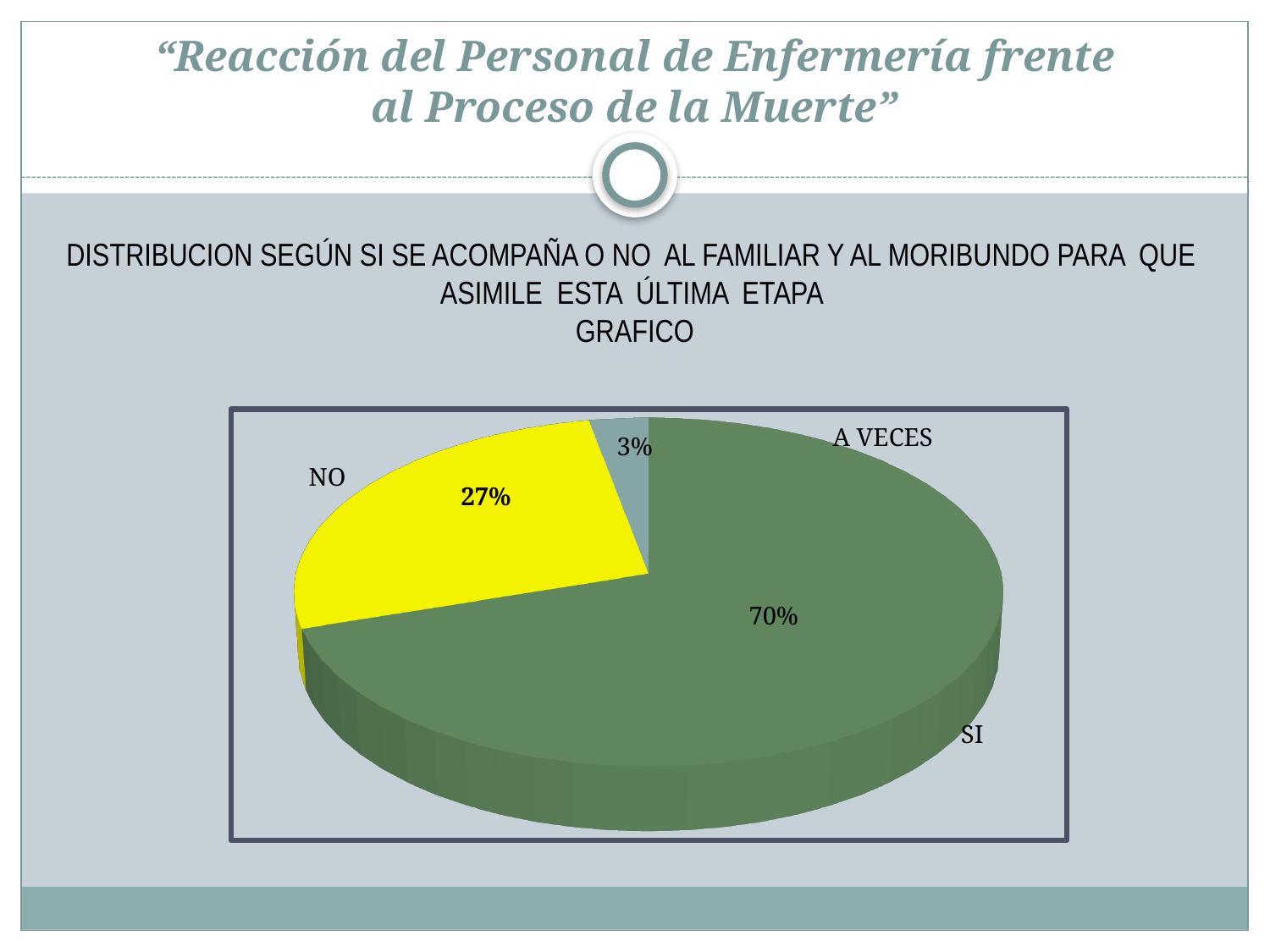
What percentage of the pie corresponds to SI? 70% How many slices does the pie chart have? 3 What is the difference in percentage points between SI and NO? 43 What kind of chart is shown on the slide? Pie chart What is the difference in percentage points between NO and A VECES? 24 What percentage of the pie corresponds to NO? 27% Which is larger, the share for NO or the share for A VECES? NO What colour is the SI slice? Green Which category has the smallest share of the pie? A VECES What colour is the NO slice? Yellow Which category has the largest share of the pie? SI What percentage of the pie corresponds to A VECES? 3%